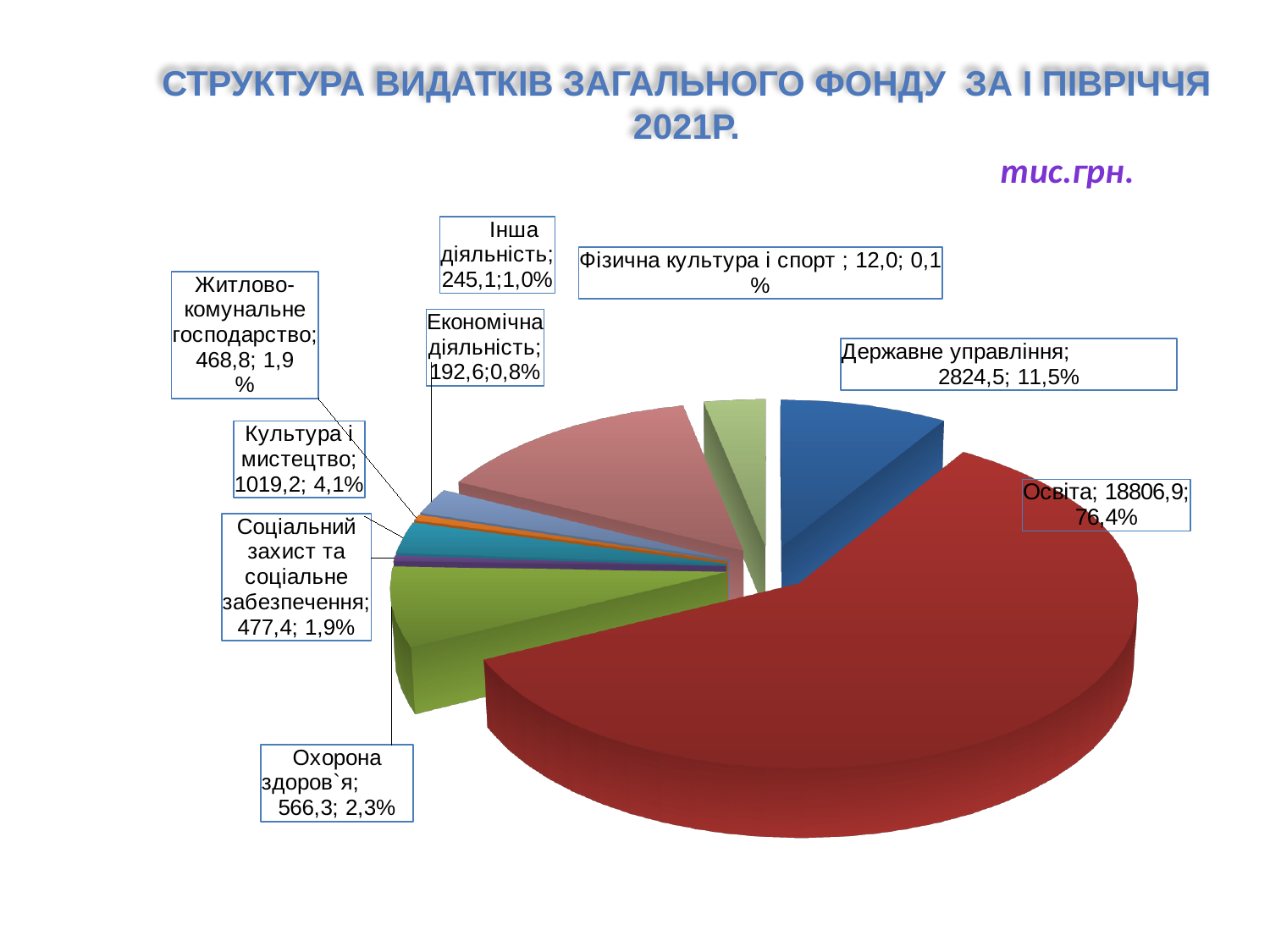
Which is larger, the value for Соціальний захист та соціальне забезпечення or the value for Економічна діяльність? Соціальний захист та соціальне забезпечення Which category has the smallest slice of the pie? Фізична культура і спорт What is the value for Освіта? 18806,9 Which category has the largest slice of the pie? Освіта What is the difference between the values for Державне управління and Культура і мистецтво? 1805,3 What kind of chart is shown on the slide? Pie chart What is the value for Державне управління? 2824,5 How many categories (slices) does the pie chart show? 9 What unit is indicated for the values on the slide? тис.грн. What is the value for Охорона здоров`я? 566,3 What percentage is shown for Культура і мистецтво? 4,1% What share of the pie does Освіта account for? 76,4%